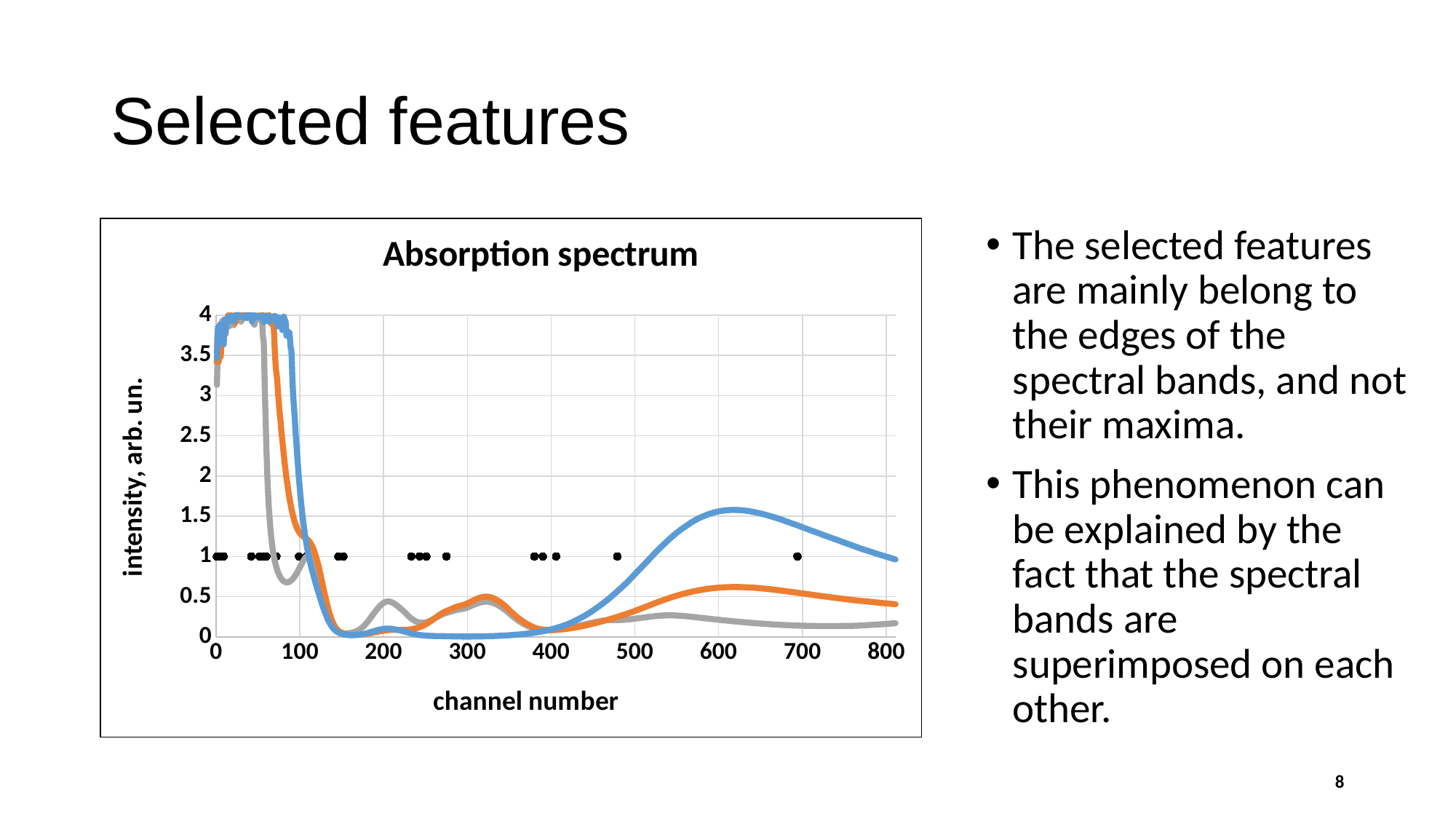
In the Absorption spectrum chart, is the value of the blue line at channel number 600 greater or less than 1? greater What is the title of the chart on the slide? Absorption spectrum In the Absorption spectrum chart, is the value of the gray line at channel number 600 greater or less than 0.5? less In the Absorption spectrum chart, is the value of the orange line at channel number 600 greater or less than 0.5? greater What type of chart is the Absorption spectrum chart? line chart At what intensity value are the black dots plotted in the Absorption spectrum chart? 1 In the Absorption spectrum chart, does the blue line rise or fall between channel number 600 and channel number 800? fall What is the label of the x axis of the Absorption spectrum chart? channel number In the Absorption spectrum chart, does the blue line rise or fall between channel number 400 and channel number 600? rise In the Absorption spectrum chart, which line has the higher value at channel number 600, the blue line or the orange line? blue line